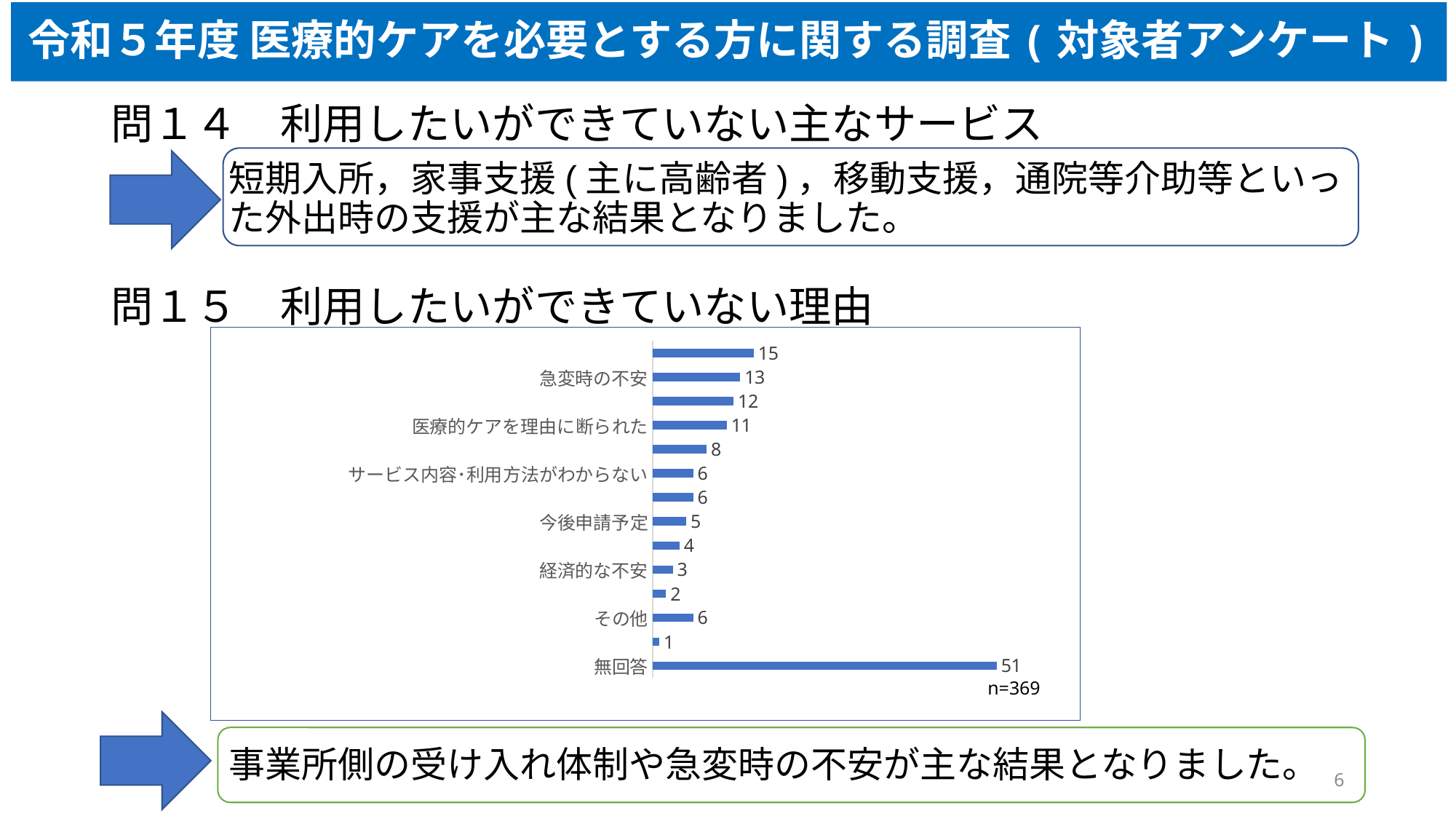
What is the value for 今後申請予定 in the 問15 chart? 5 Which category has the highest value in the 問15 chart? 無回答 What is the value for 医療的ケアを理由に断られた in the 問15 chart? 11 What is the value for 経済的な不安 in the 問15 chart? 3 What is the value for その他 in the 問15 chart? 6 What is the value for 無回答 in the 問15 chart? 51 What kind of chart is shown for 問15? Bar chart What is the difference between 急変時の不安 and 医療的ケアを理由に断られた in the 問15 chart? 2 What is the value for 急変時の不安 in the 問15 chart? 13 How many bars are plotted in the 問15 chart? 14 What sample size (n) is noted on the 問15 chart? n=369 Which is larger in the 問15 chart, 今後申請予定 or 経済的な不安? 今後申請予定